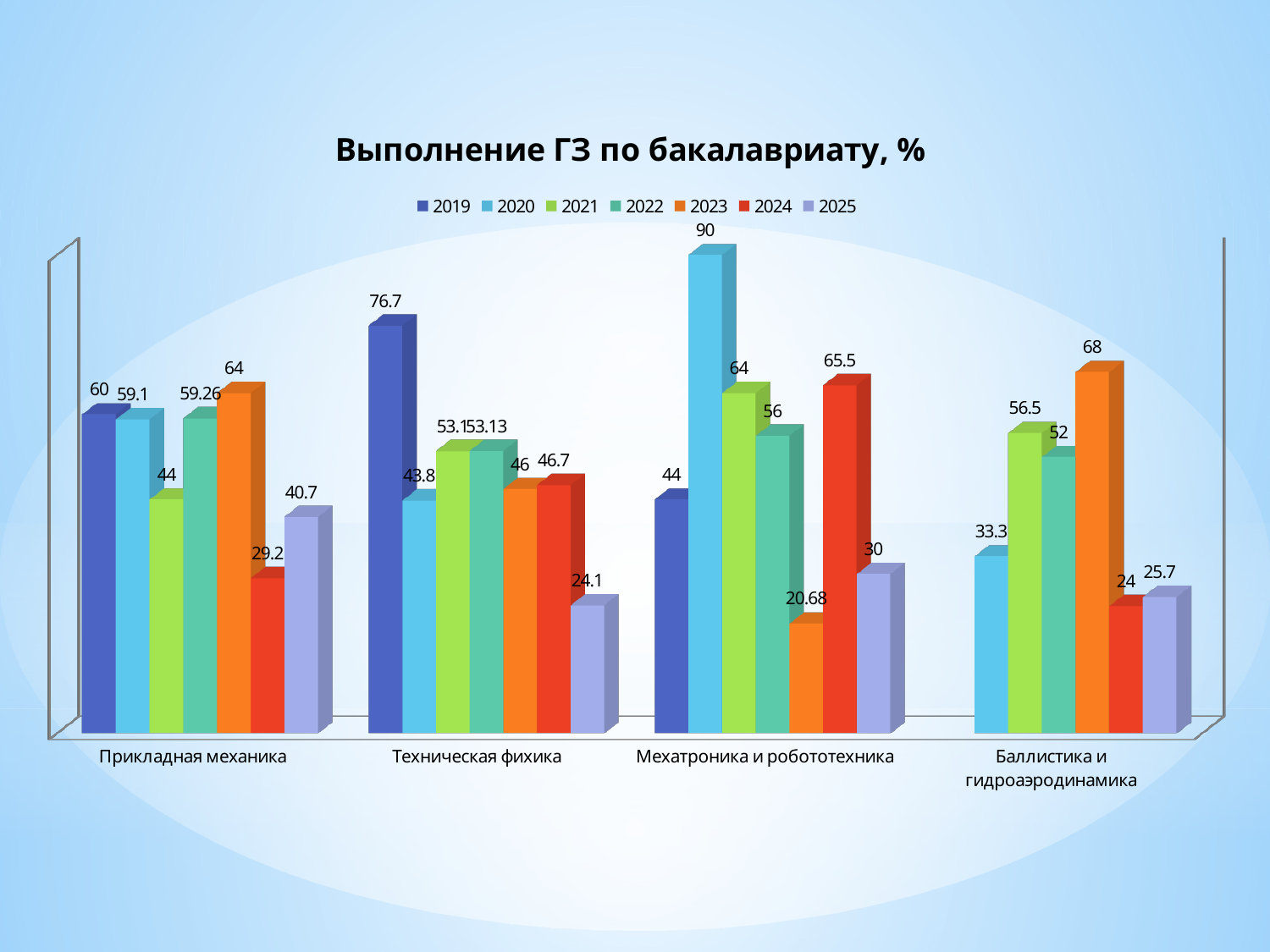
Which year has the highest value in the Мехатроника и робототехника category? 2020 How many categories are shown on the x axis? 4 What is the difference between the 2020 and 2023 values in the Мехатроника и робототехника category? 69.32 What is the value for 2019 in the Прикладная механика category? 60 What type of chart is shown on the slide? Bar chart What is the value for 2020 in the Мехатроника и робототехника category? 90 Which category has the highest value for 2023? Баллистика и гидроаэродинамика What is the value for 2023 in the Баллистика и гидроаэродинамика category? 68 Which is larger for 2019: Прикладная механика or Техническая фихика? Техническая фихика What is the value for 2025 in the Техническая фихика category? 24.1 Which year has the lowest value in the Прикладная механика category? 2024 How many series does the legend list? 7